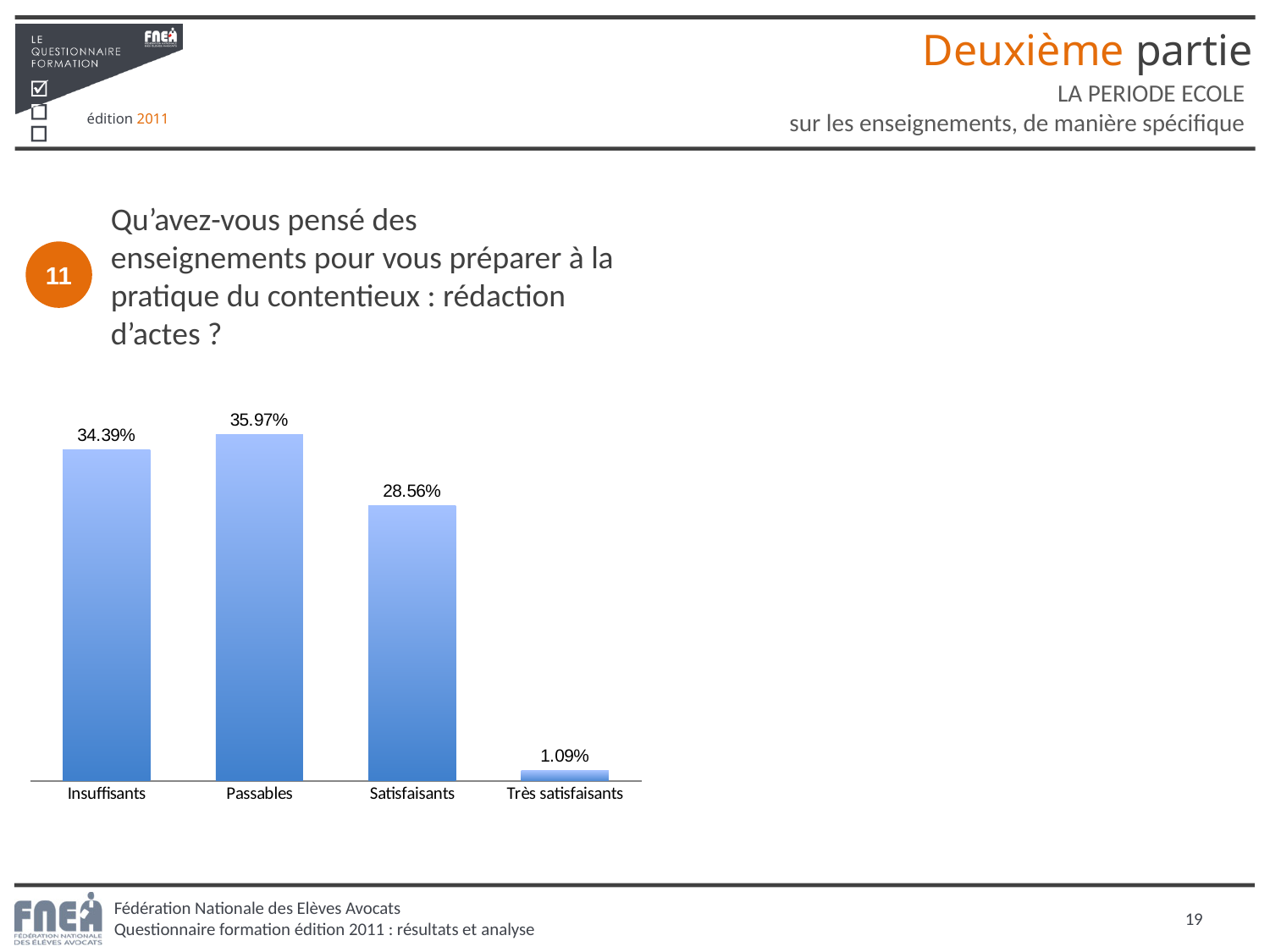
Do the values rise or fall from Passables to Très satisfaisants along the x axis? Fall What is the value for Satisfaisants? 28.56% What is the value for Insuffisants? 34.39% What is the difference between the values for Satisfaisants and Très satisfaisants? 27.47% Which category has the lowest value? Très satisfaisants What is the value for Très satisfaisants? 1.09% Which category has the highest value? Passables Which is larger, the value for Insuffisants or the value for Satisfaisants? Insuffisants What kind of chart is shown on the slide? Bar chart How many categories are shown in the chart? 4 What is the value for Passables? 35.97% What is the difference between the values for Passables and Insuffisants? 1.58%